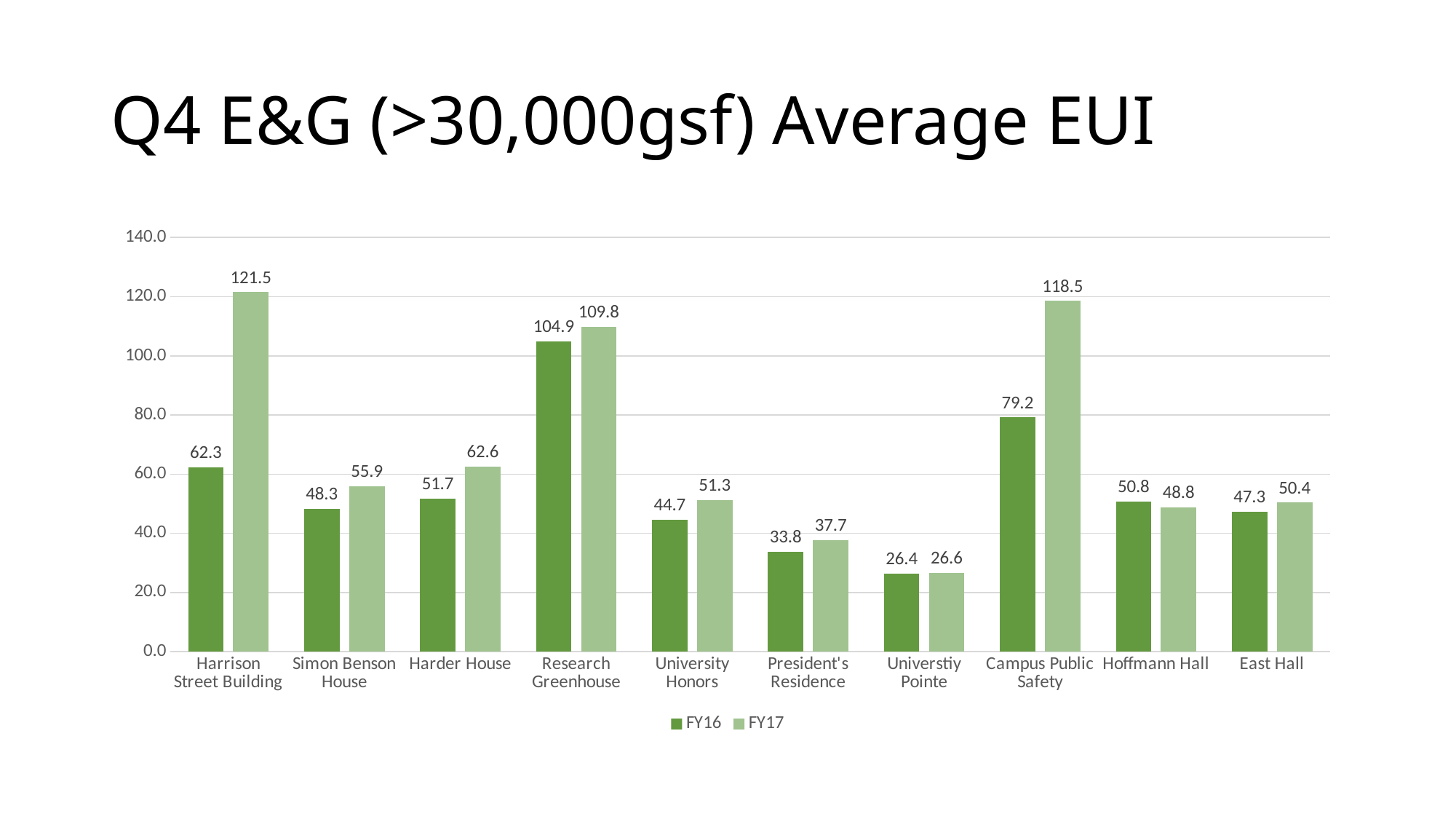
Which is larger for Hoffmann Hall, the FY16 value or the FY17 value? FY16 What is the title of the chart? Q4 E&G (>30,000gsf) Average EUI Which building has the highest FY16 value? Research Greenhouse What kind of chart is shown on the slide? Bar chart How many series does the legend list? 2 What is the FY16 value for Campus Public Safety? 79.2 How many buildings are shown on the x axis? 10 What is the difference between the FY17 and FY16 values for Campus Public Safety? 39.3 Which building has the lowest FY17 value? Universtiy Pointe Is the FY17 value for Research Greenhouse greater or less than 100.0? greater What is the FY17 value for Harrison Street Building? 121.5 What is the FY16 value for President's Residence? 33.8